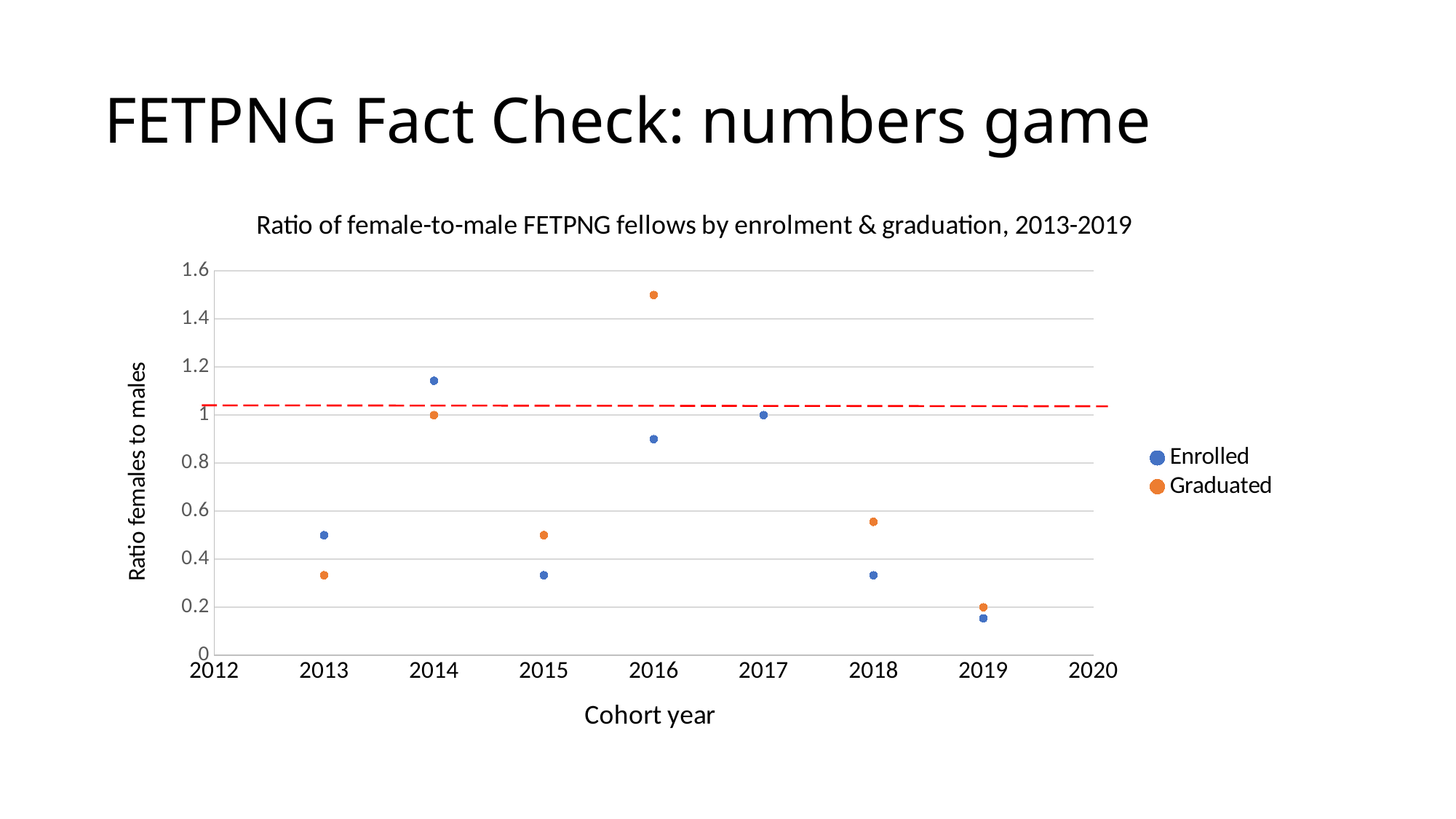
What is the Graduated ratio for the 2014 cohort? 1 What is the Graduated ratio for the 2019 cohort? 0.2 For the 2014 cohort, which is larger: the Enrolled ratio or the Graduated ratio? Enrolled Which cohort year has the lowest Enrolled ratio? 2019 What is the Enrolled ratio for the 2017 cohort? 1 Which cohort year has the highest Graduated ratio? 2016 What is the label on the x axis? Cohort year How many series does the legend list? 2 How many cohort years have data points plotted? 7 What are the two series named in the legend? Enrolled and Graduated Is the Graduated ratio for the 2016 cohort greater or less than 1.4? greater What kind of chart is shown on the slide? scatter chart